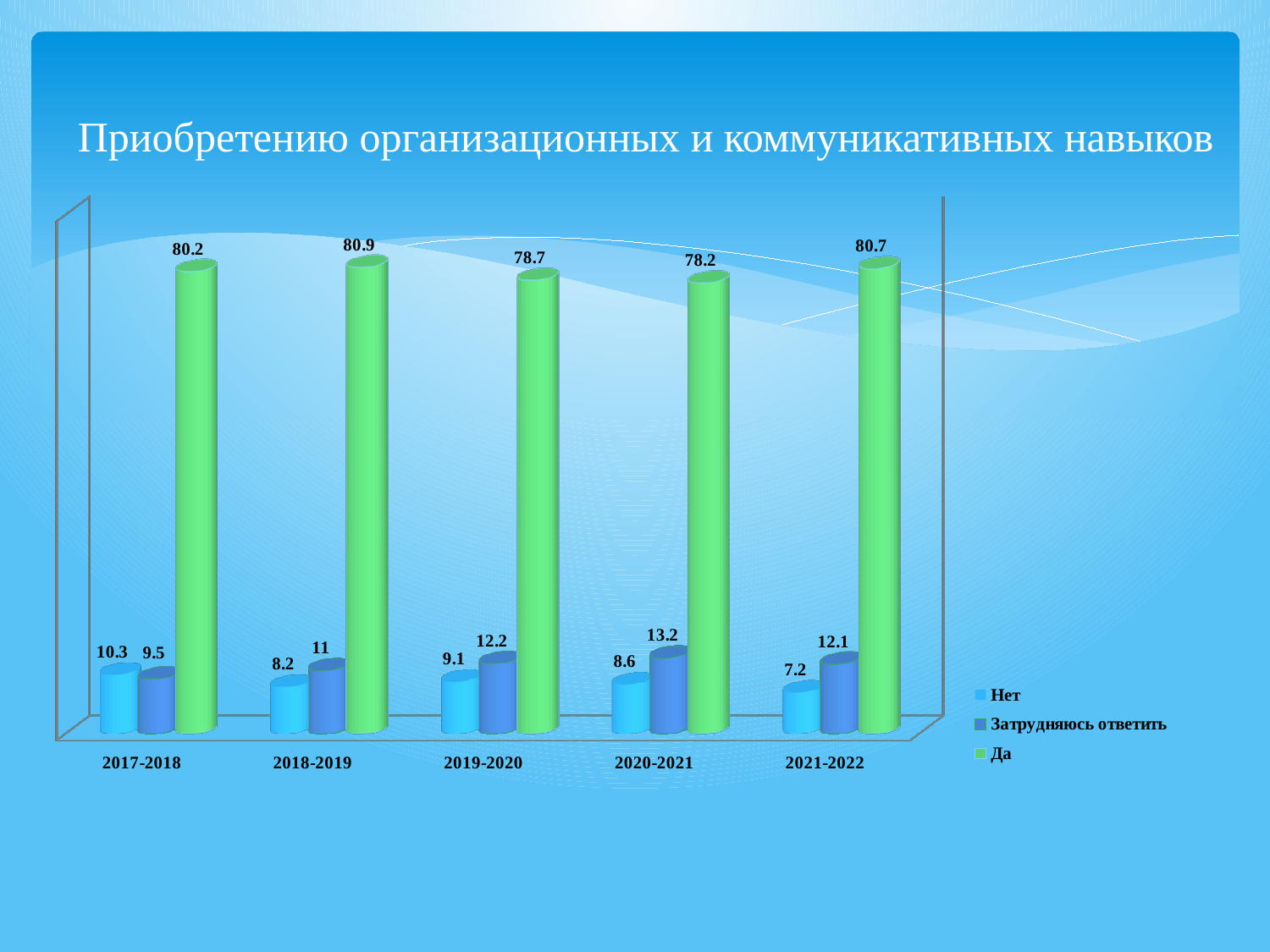
What is the title of the chart? Приобретению организационных и коммуникативных навыков How many series does the legend list? 3 In which period is the value for "Да" the lowest? 2020-2021 What is the value for "Затрудняюсь ответить" in 2020-2021? 13.2 What is the value for "Нет" in 2021-2022? 7.2 How many periods are shown on the x axis? 5 What is the value for "Да" in 2018-2019? 80.9 Does the value for "Нет" rise or fall from 2017-2018 to 2021-2022 overall? Fall Which is larger in 2017-2018: the value for "Нет" or the value for "Затрудняюсь ответить"? Нет What kind of chart is shown on the slide? Bar chart What is the difference between the "Да" values for 2018-2019 and 2020-2021? 2.7 In which period is the value for "Нет" the highest? 2017-2018